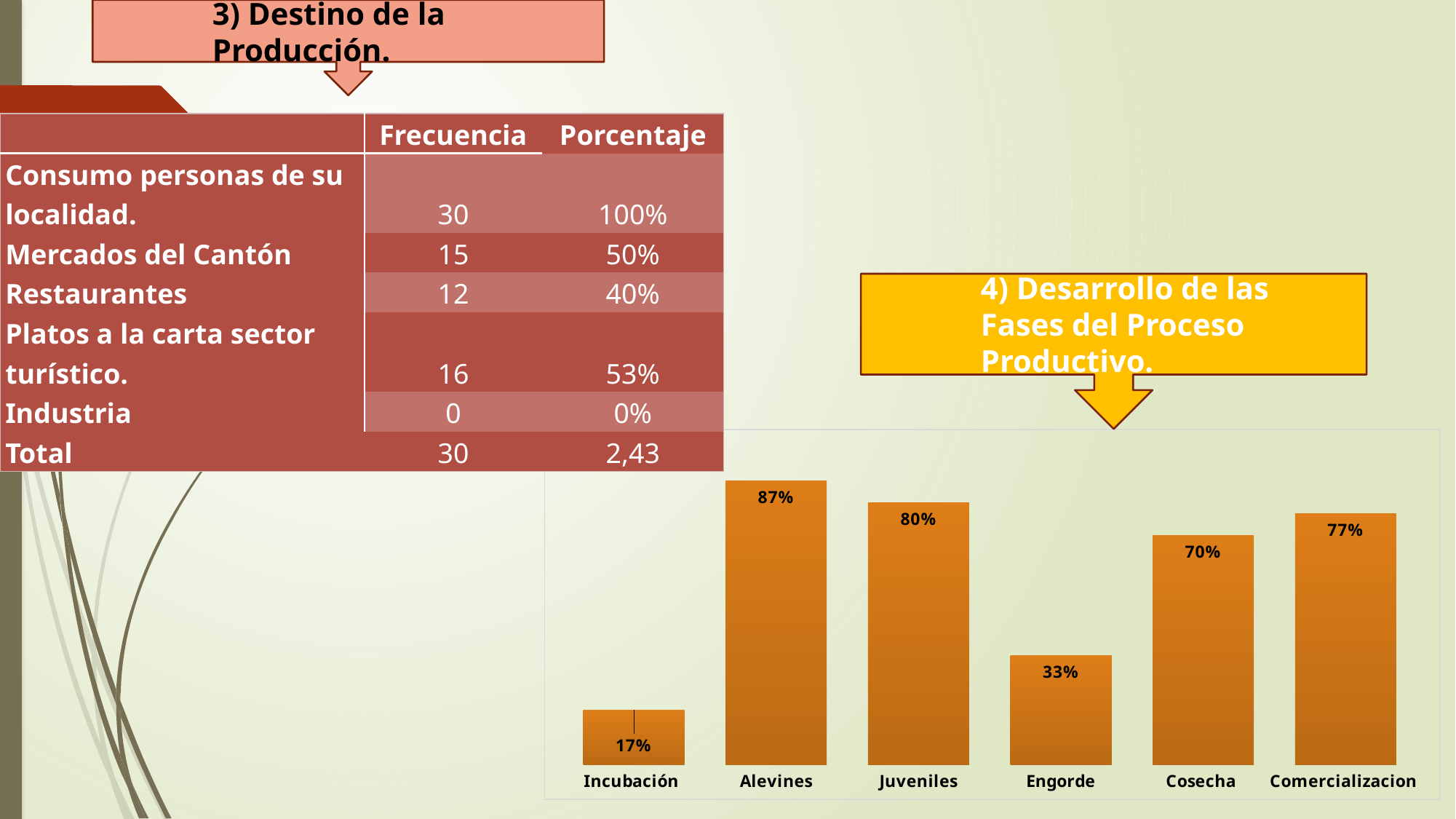
How many categories are shown in the bar chart? 6 What is the value for Engorde in the bar chart? 33% Which category has the lowest value in the bar chart? Incubación What is the difference between the values for Alevines and Juveniles in the bar chart? 7% Which category has the highest value in the bar chart? Alevines What is the difference between the values for Cosecha and Engorde in the bar chart? 37% What is the value for Comercializacion in the bar chart? 77% What is the value for Alevines in the bar chart? 87% What is the value for Incubación in the bar chart? 17% What colour are the bars in the bar chart? orange Which is larger in the bar chart, the value for Juveniles or the value for Cosecha? Juveniles What kind of chart is shown on the slide? bar chart